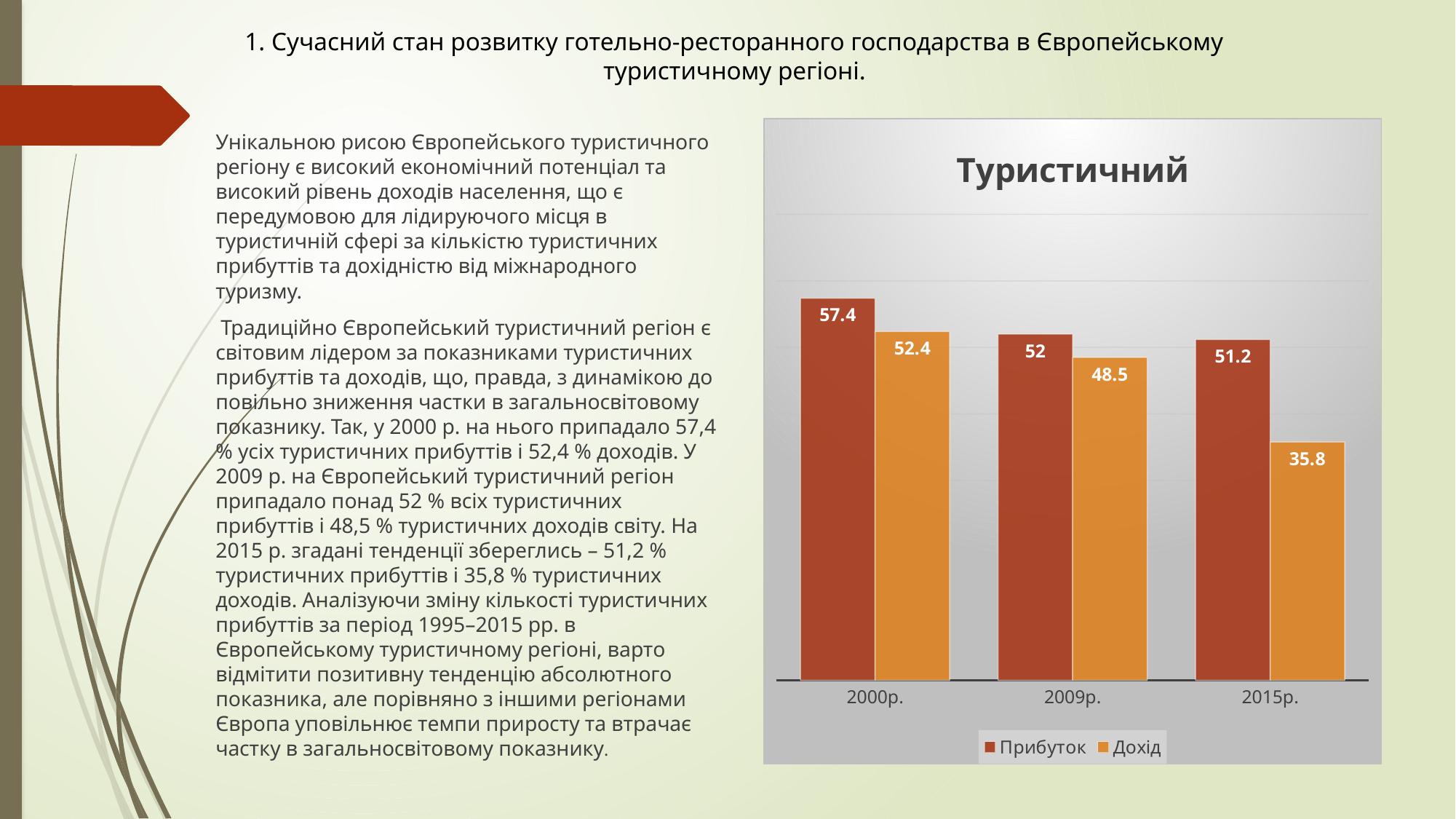
What is the value of Дохід for 2009р.? 48.5 Which is larger in 2009р., Прибуток or Дохід? Прибуток What is the difference between Прибуток and Дохід in 2015р.? 15.4 What kind of chart is shown on the slide? Bar chart What is the value of Прибуток for 2000р.? 57.4 How many years are shown on the x axis? 3 What is the value of Прибуток for 2015р.? 51.2 What is the value of Дохід for 2015р.? 35.8 In which year is Прибуток the highest? 2000р. In which year is Дохід the lowest? 2015р. How many series does the legend list? 2 What is the difference between Дохід in 2000р. and Дохід in 2009р.? 3.9